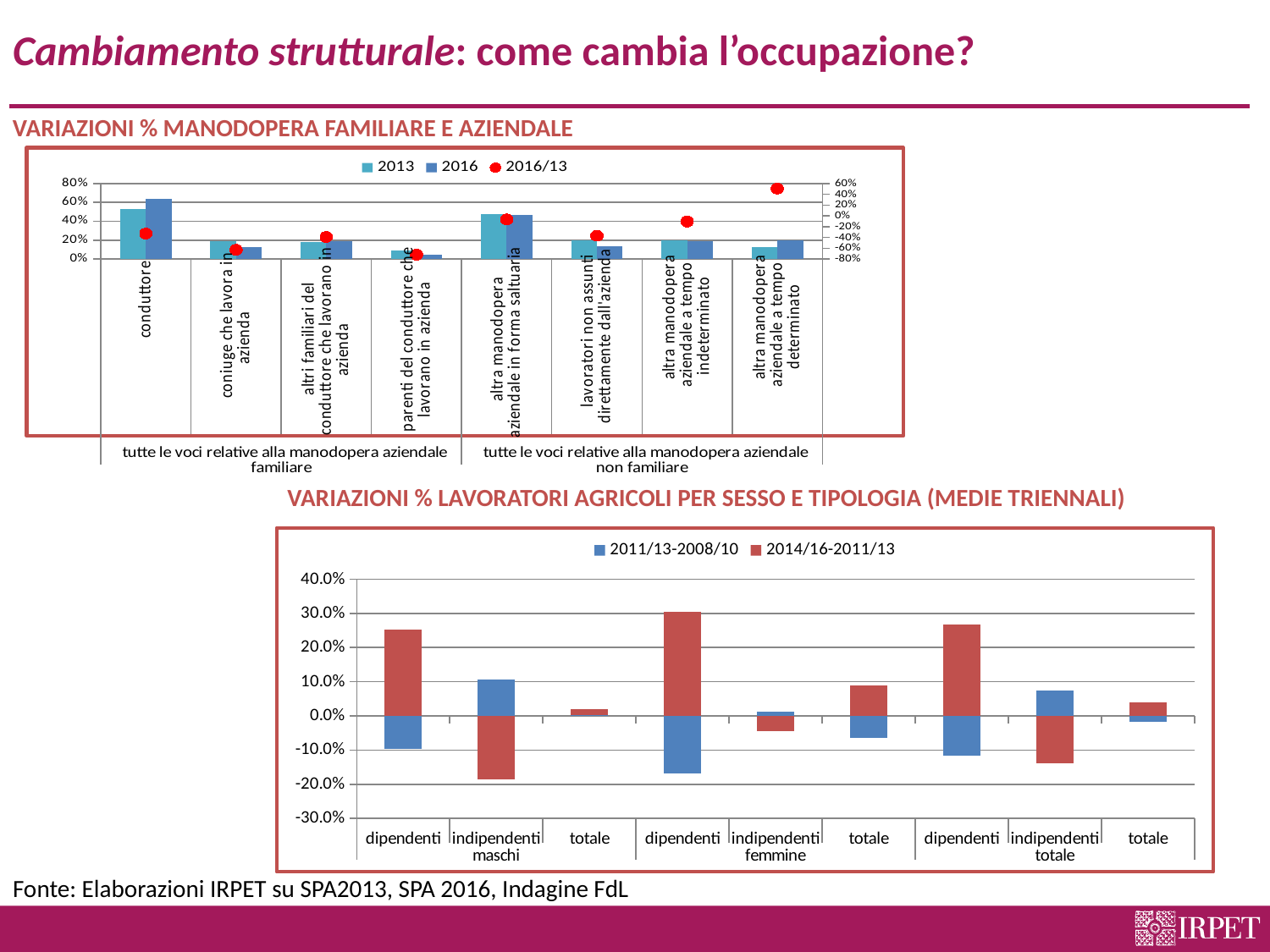
What kind of chart is the top chart, 'VARIAZIONI % MANODOPERA FAMILIARE E AZIENDALE'? combination bar and line chart (bars with red dot markers) How many series does the legend of the top chart, 'VARIAZIONI % MANODOPERA FAMILIARE E AZIENDALE', list? 3 How many categories are shown on the x axis of the top chart, 'VARIAZIONI % MANODOPERA FAMILIARE E AZIENDALE'? 8 In the bottom chart, 'VARIAZIONI % LAVORATORI AGRICOLI PER SESSO E TIPOLOGIA (MEDIE TRIENNALI)', which is larger for dipendenti maschi: the 2011/13-2008/10 value or the 2014/16-2011/13 value? 2014/16-2011/13 How many series does the legend of the bottom chart, 'VARIAZIONI % LAVORATORI AGRICOLI PER SESSO E TIPOLOGIA (MEDIE TRIENNALI)', list? 2 In the bottom chart, 'VARIAZIONI % LAVORATORI AGRICOLI PER SESSO E TIPOLOGIA (MEDIE TRIENNALI)', which category has the lowest 2011/13-2008/10 value? dipendenti femmine What kind of chart is the bottom chart, 'VARIAZIONI % LAVORATORI AGRICOLI PER SESSO E TIPOLOGIA (MEDIE TRIENNALI)'? bar chart In the top chart, 'VARIAZIONI % MANODOPERA FAMILIARE E AZIENDALE', which is larger for conduttore: the 2013 bar or the 2016 bar? 2016 In the top chart, 'VARIAZIONI % MANODOPERA FAMILIARE E AZIENDALE', is the 2013 value for conduttore greater or less than 40%? greater In the bottom chart, 'VARIAZIONI % LAVORATORI AGRICOLI PER SESSO E TIPOLOGIA (MEDIE TRIENNALI)', is the 2014/16-2011/13 value for dipendenti femmine greater or less than 20.0%? greater In the top chart, 'VARIAZIONI % MANODOPERA FAMILIARE E AZIENDALE', which series is shown as red dots? 2016/13 In the top chart, 'VARIAZIONI % MANODOPERA FAMILIARE E AZIENDALE', which category has the highest 2016 bar? conduttore